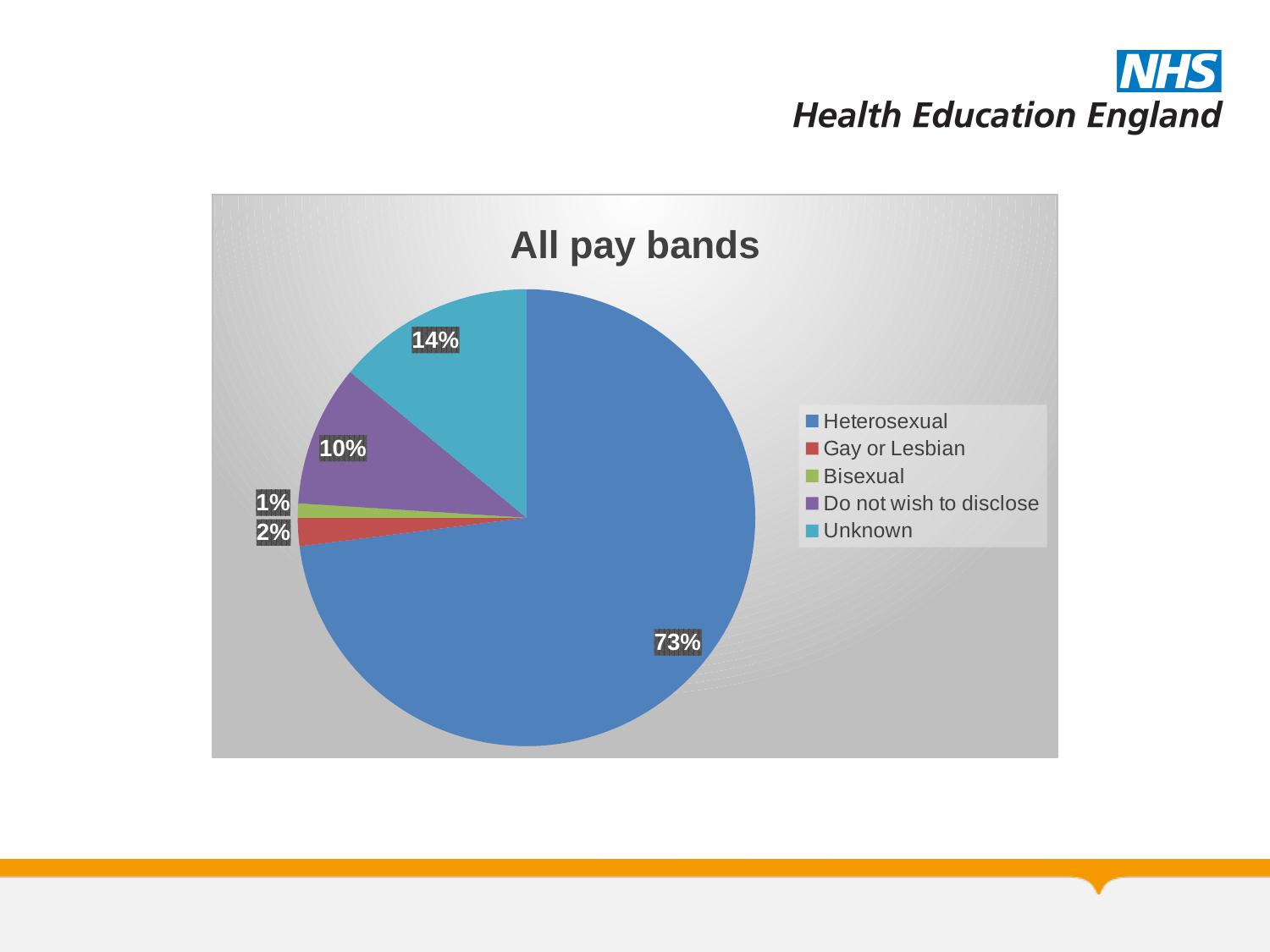
What percentage of the pie is Heterosexual? 73% What percentage of the pie is Gay or Lesbian? 2% What is the difference in percentage points between Unknown and Do not wish to disclose? 4 What percentage of the pie is Unknown? 14% Which category has the largest share of the pie? Heterosexual What percentage of the pie is Bisexual? 1% Which is larger, the share for Unknown or the share for Do not wish to disclose? Unknown What is the title of the chart? All pay bands What percentage of the pie is Do not wish to disclose? 10% What type of chart is shown on the slide? pie chart How many categories does the legend list? 5 Which category has the smallest share of the pie? Bisexual